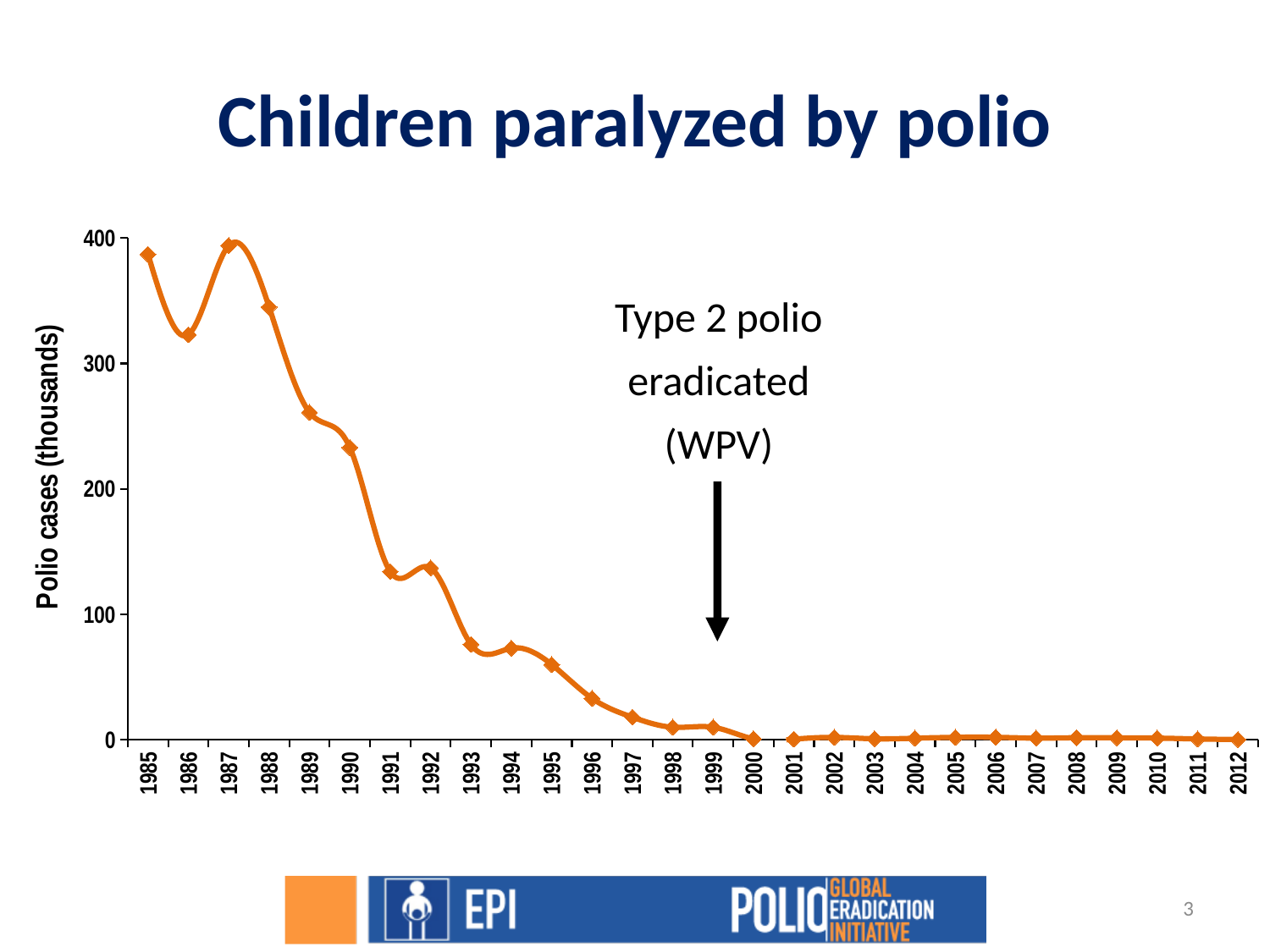
Is the value for 1989 greater or less than 300? less Is the value for 1990 greater or less than 200? greater How many years are plotted along the x axis of the chart? 28 Which year has the larger value, 1985 or 1990? 1985 What kind of chart is shown on the slide? line chart Which year has the larger value, 1988 or 1995? 1988 What is the title of the chart? Children paralyzed by polio Is the value for 1985 greater or less than 300? greater What is the label on the vertical axis of the chart? Polio cases (thousands) Do polio cases generally rise or fall from 1985 to 2012? fall